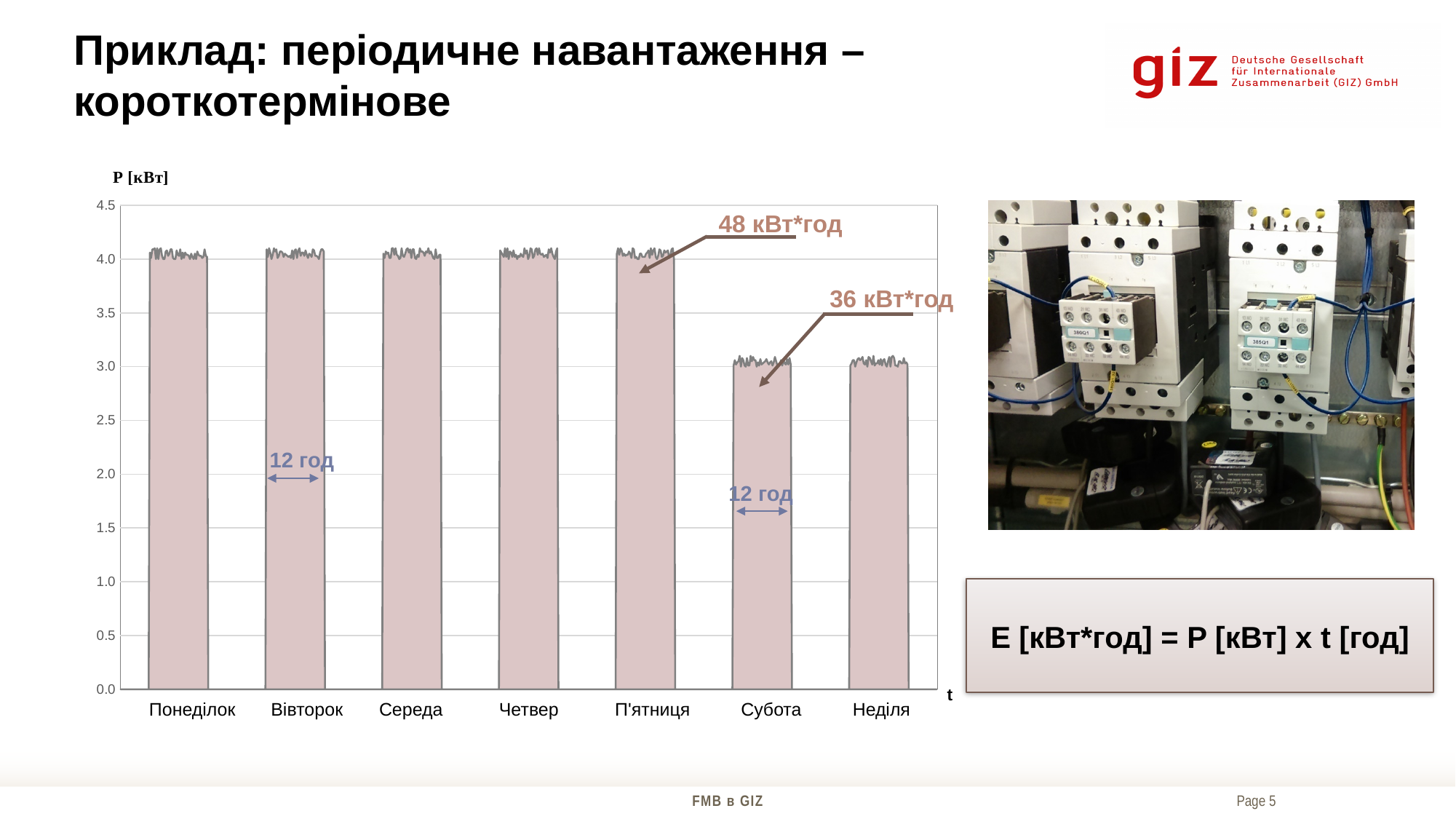
Is the value for Понеділок greater or less than 3.5? greater Is the value for Неділя greater or less than 2.5? greater Is the value for Середа greater or less than 4.5? less Which is larger, the value for П'ятниця or the value for Субота? П'ятниця What is the label of the vertical axis of the chart? P [кВт] How many categories (days) are shown on the x axis of the chart? 7 Do the values rise or fall from П'ятниця to Субота? fall What kind of chart is shown on the slide? bar chart What energy value is annotated for the Субота bar? 36 кВт*год What energy value is annotated for the П'ятниця bar? 48 кВт*год Which is larger, the value for Неділя or the value for Четвер? Четвер